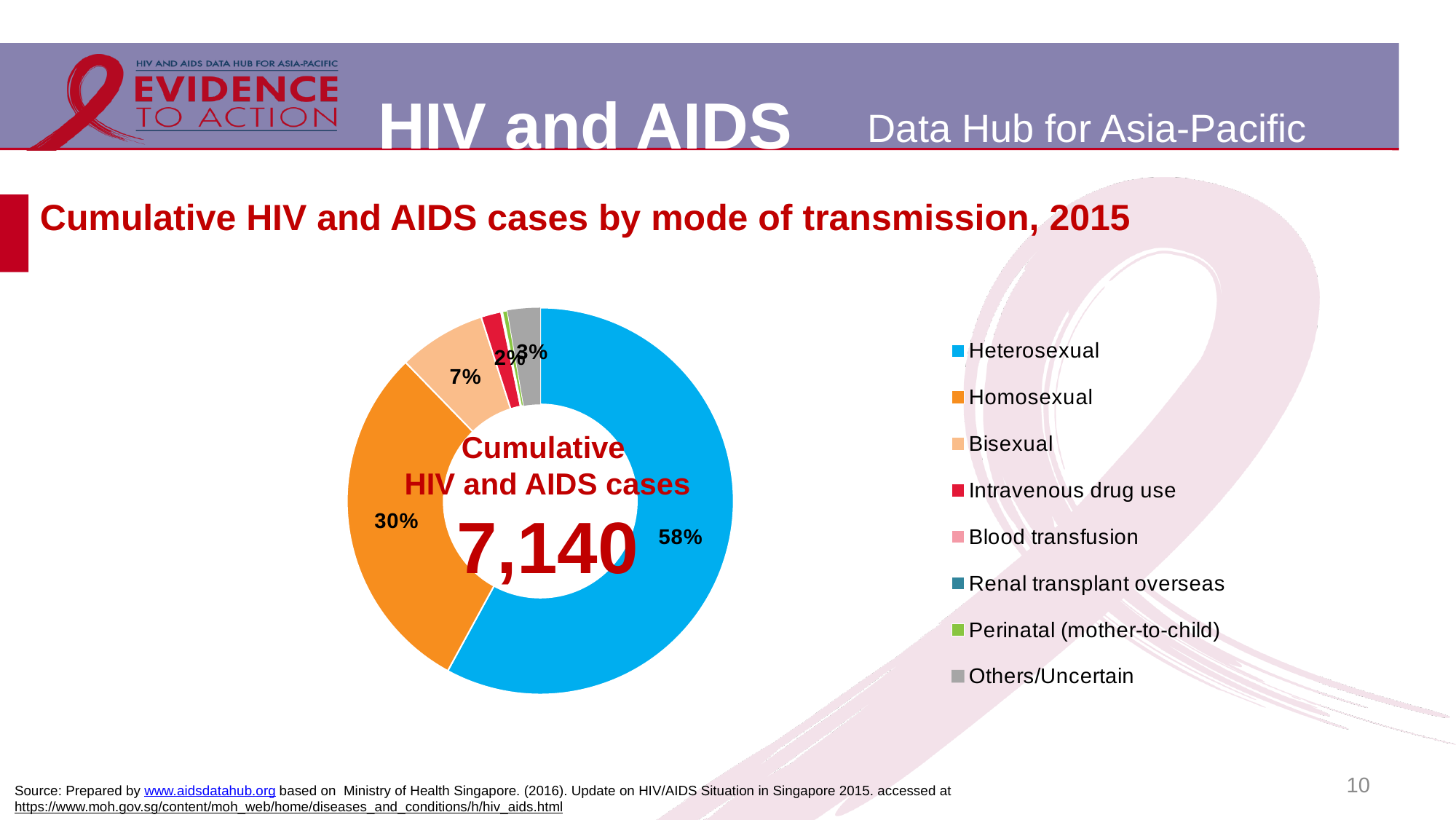
How many modes of transmission are listed in the legend? 8 By how many percentage points does the heterosexual share exceed the homosexual share? 28 percentage points Which accounts for a larger share of cases, homosexual or bisexual transmission? Homosexual What colour represents heterosexual transmission in the chart? Blue What percentage of cumulative cases is attributed to bisexual transmission? 7% Which mode of transmission accounts for the largest share of cumulative HIV and AIDS cases? Heterosexual What percentage of cumulative cases falls under Others/Uncertain? 3% What percentage of cumulative cases is attributed to intravenous drug use? 2% What is the total number of cumulative HIV and AIDS cases shown in the centre of the chart? 7,140 What percentage of cumulative cases is attributed to homosexual transmission? 30% What share of cumulative HIV and AIDS cases is attributed to heterosexual transmission? 58% What type of chart is used on this slide? Pie (donut) chart